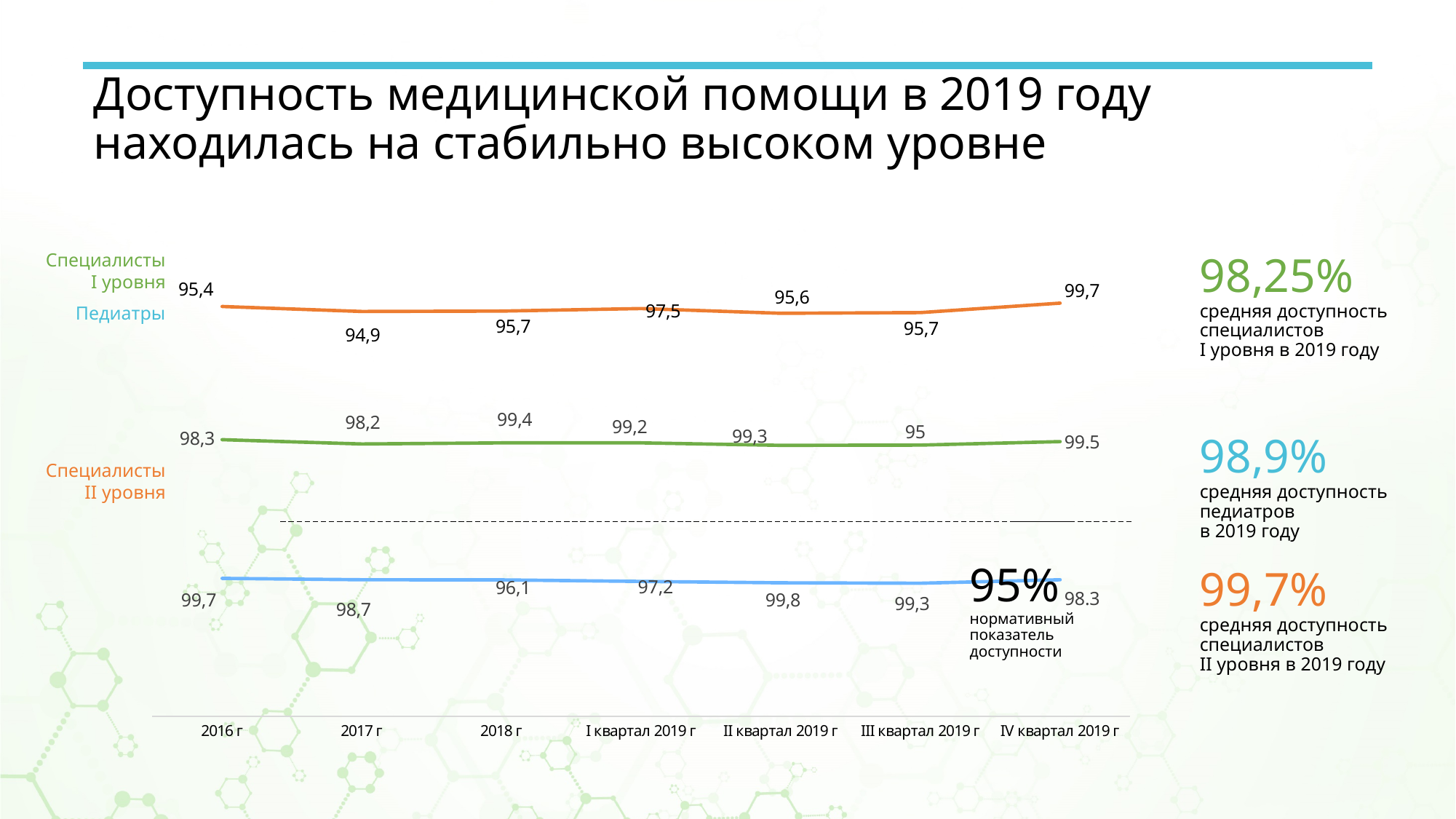
What kind of chart is shown on the slide? line chart At which x-axis point does the green line (Специалисты I уровня) have its lowest value? III квартал 2019 г At which x-axis point does the orange line (Специалисты II уровня) reach its highest value? IV квартал 2019 г At which x-axis point does the orange line (Специалисты II уровня) have its lowest value? 2017 г What is the value of the blue line (Педиатры) for 2017 г? 98,7 What is the value of the orange line (Специалисты II уровня) for IV квартал 2019 г? 99,7 How many series (lines) are plotted on the chart? 3 What is the difference between the orange line's values for 2016 г (95,4) and 2017 г (94,9)? 0,5 What normative availability indicator (нормативный показатель доступности) is marked on the chart? 95% What is the value of the green line (Специалисты I уровня) for 2016 г? 98,3 How many points along the x axis does the chart have? 7 On the blue line (Педиатры), which is larger: the value for 2016 г or the value for 2018 г? 2016 г